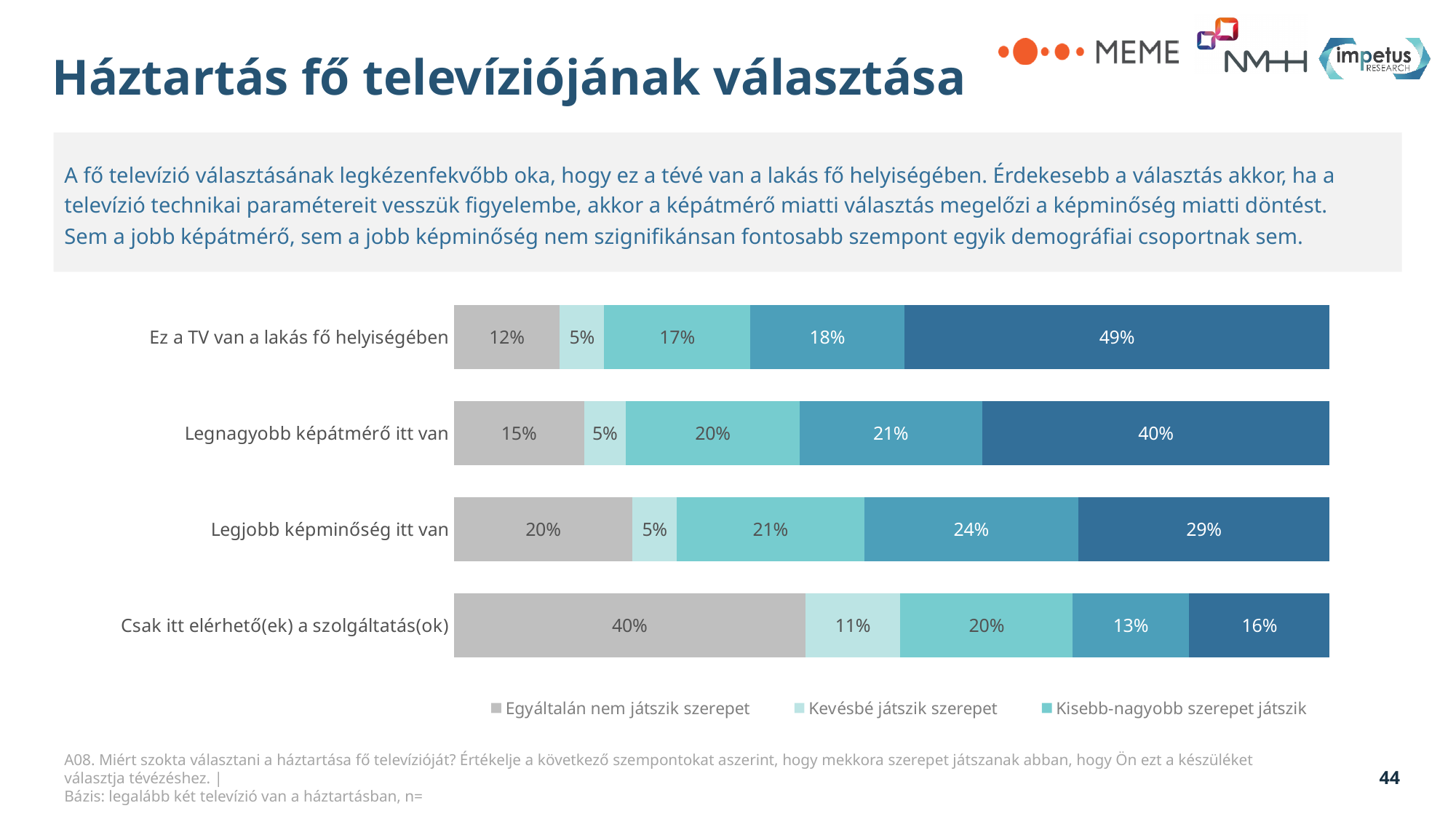
What is the value of "Egyáltalán nem játszik szerepet" for "Csak itt elérhető(ek) a szolgáltatás(ok)"? 40% Which has the larger "Kevésbé játszik szerepet" value: "Csak itt elérhető(ek) a szolgáltatás(ok)" or "Ez a TV van a lakás fő helyiségében"? Csak itt elérhető(ek) a szolgáltatás(ok) Which category has the highest value for "Egyáltalán nem játszik szerepet"? Csak itt elérhető(ek) a szolgáltatás(ok) What kind of chart is shown on the slide? Stacked bar chart How many categories (bars) does the chart show? 4 What is the value of "Kevésbé játszik szerepet" for "Legnagyobb képátmérő itt van"? 5% What is the difference between the darkest blue (rightmost) segment of "Ez a TV van a lakás fő helyiségében" and that of "Legjobb képminőség itt van"? 20 percentage points What colour represents "Egyáltalán nem játszik szerepet" in the chart? Grey What is the value of "Kisebb-nagyobb szerepet játszik" for "Legjobb képminőség itt van"? 21% What is the value of the darkest blue (rightmost) segment for "Ez a TV van a lakás fő helyiségében"? 49% How many series does the chart's legend list? 3 Which category has the lowest value for "Egyáltalán nem játszik szerepet"? Ez a TV van a lakás fő helyiségében